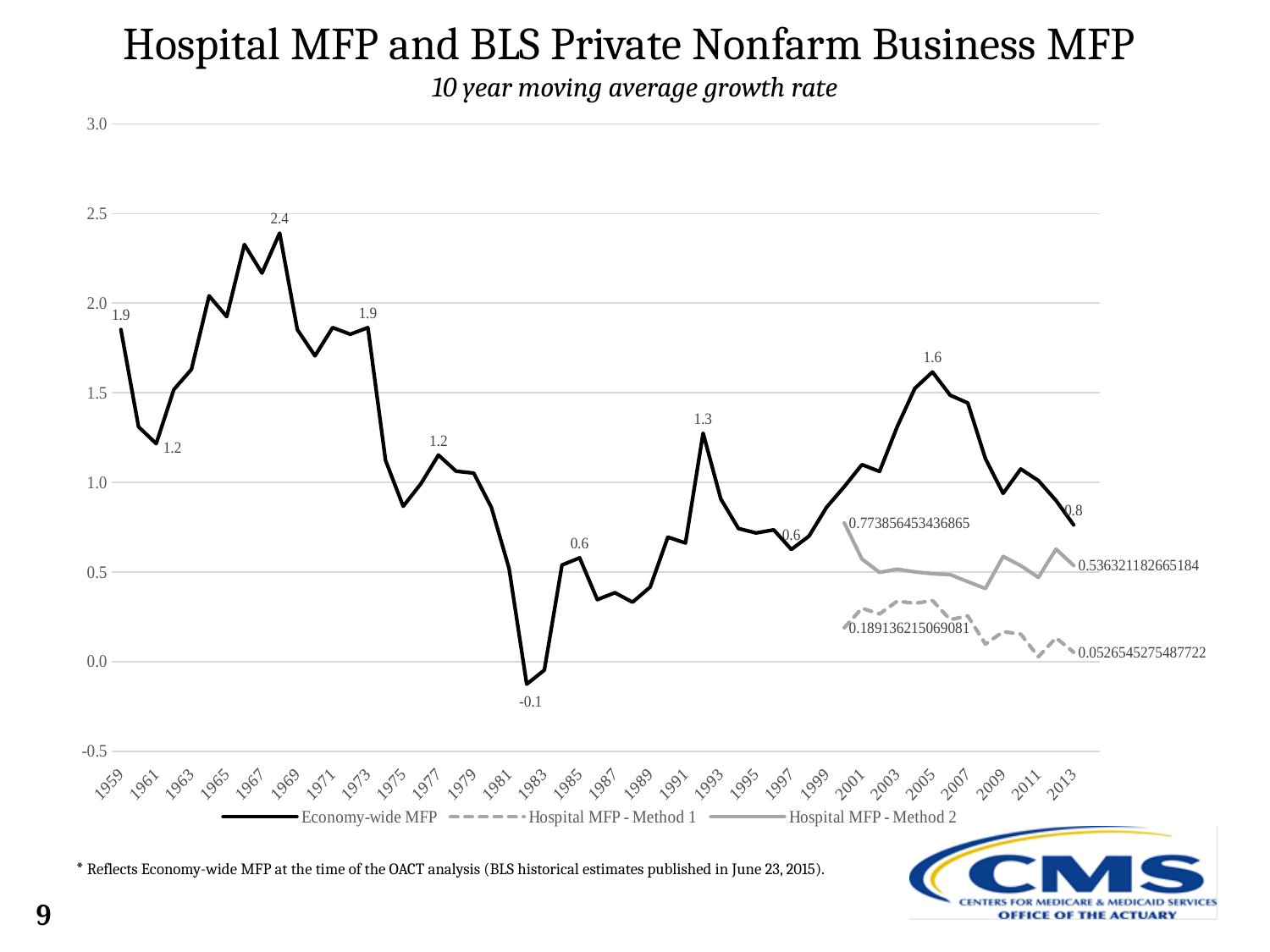
What kind of chart is shown on the slide? line chart What is the lowest labeled value on the Economy-wide MFP line? -0.1 What is the value of Economy-wide MFP in 2005? 1.6 What is the value of Economy-wide MFP in 2013? 0.8 How many series does the legend list? 3 What is the difference between the Economy-wide MFP value in 2005 (1.6) and in 2013 (0.8)? 0.8 At the end of the series, which is larger: Hospital MFP - Method 1 or Hospital MFP - Method 2? Hospital MFP - Method 2 What is the final labeled value of the Hospital MFP - Method 1 line? 0.0526545275487722 What is the highest labeled value on the Economy-wide MFP line? 2.4 Is the value for Economy-wide MFP in 1965 greater or less than 1.5? greater What is the value of Economy-wide MFP in 1959? 1.9 What is the final labeled value of the Hospital MFP - Method 2 line? 0.536321182665184